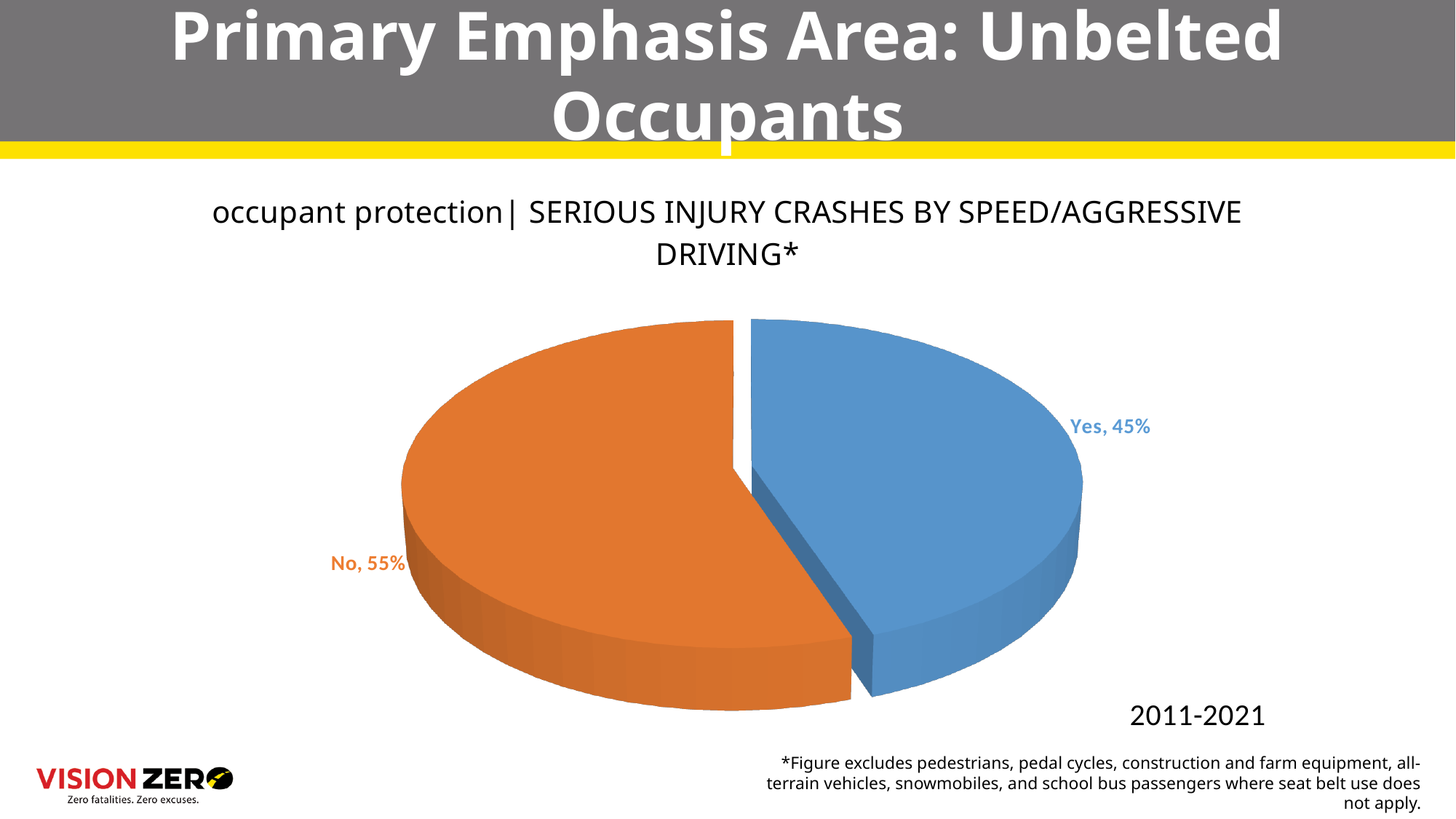
How many slices does the pie chart have? 2 What share of the pie does the "Yes" slice represent? 45% Which slice of the pie is the largest? No What time period is shown for the chart data? 2011-2021 Which slice of the pie is the smallest? Yes Which is larger, the "Yes" slice or the "No" slice? No What colour is the "No" slice of the pie? orange What is the difference in percentage points between the "No" and "Yes" slices? 10 What kind of chart is shown on the slide? pie chart What percentage of serious injury crashes is labelled "Yes" for speed/aggressive driving? 45% What percentage of serious injury crashes is labelled "No" for speed/aggressive driving? 55%